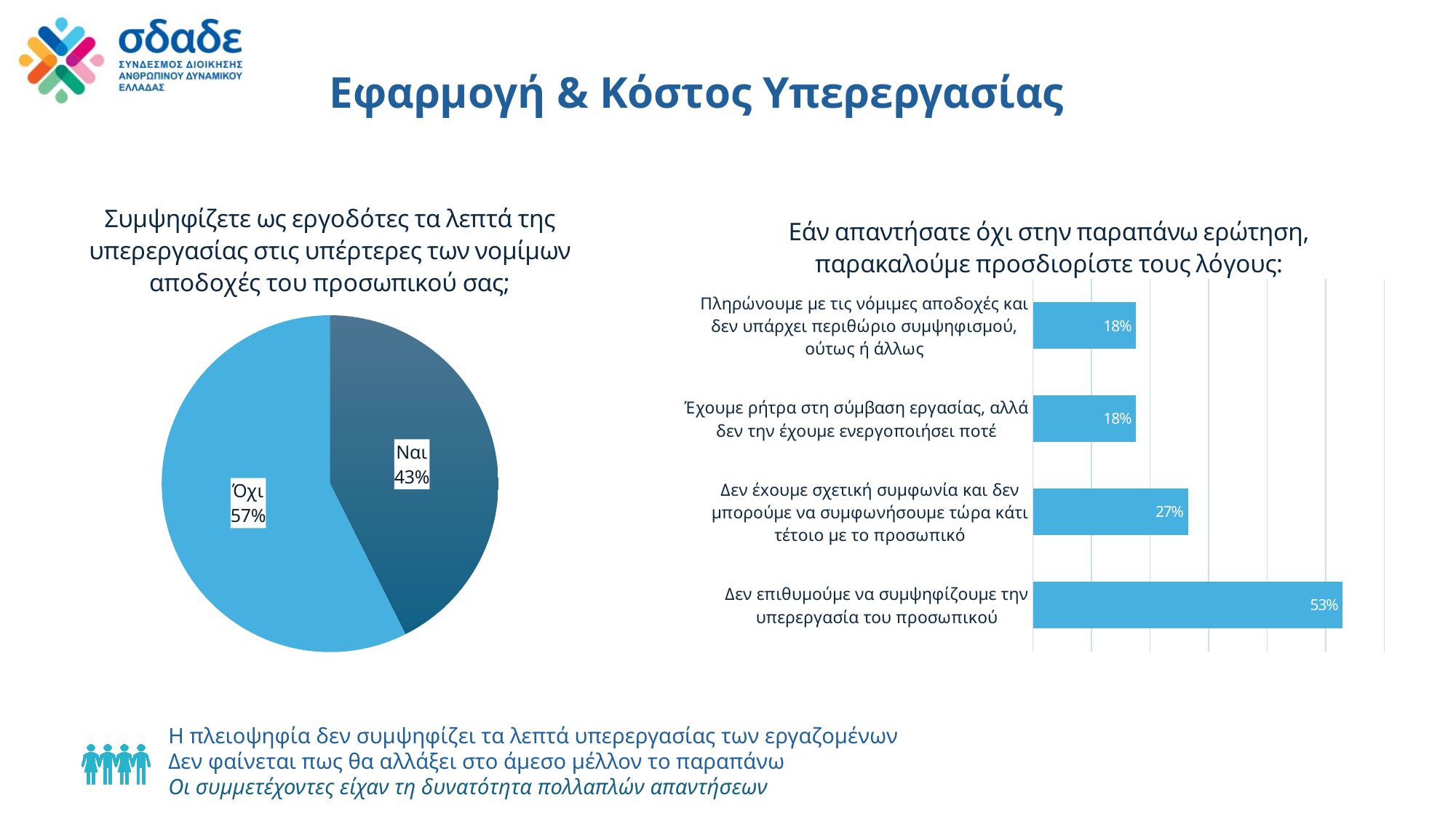
In the pie chart on the left, what percentage of respondents answered 'Όχι'? 57% In the bar chart on the right, how many categories are shown? 4 In the bar chart on the right, what is the difference between the highest value (53%) and the value for 'Έχουμε ρήτρα στη σύμβαση εργασίας, αλλά δεν την έχουμε ενεργοποιήσει ποτέ'? 35% In the bar chart on the right, what is the value for 'Δεν επιθυμούμε να συμψηφίζουμε την υπερεργασία του προσωπικού'? 53% In the bar chart on the right, which category has the highest value? Δεν επιθυμούμε να συμψηφίζουμε την υπερεργασία του προσωπικού What kind of chart is shown on the left side of the slide? Pie chart In the pie chart on the left, how many slices are there? 2 In the pie chart on the left, what percentage of respondents answered 'Ναι'? 43% What kind of chart is shown on the right side of the slide? Bar chart In the pie chart on the left, what is the difference in percentage points between 'Όχι' and 'Ναι'? 14% In the pie chart on the left, which answer has the larger share, 'Ναι' or 'Όχι'? Όχι In the bar chart on the right, what is the value for 'Δεν έχουμε σχετική συμφωνία και δεν μπορούμε να συμφωνήσουμε τώρα κάτι τέτοιο με το προσωπικό'? 27%